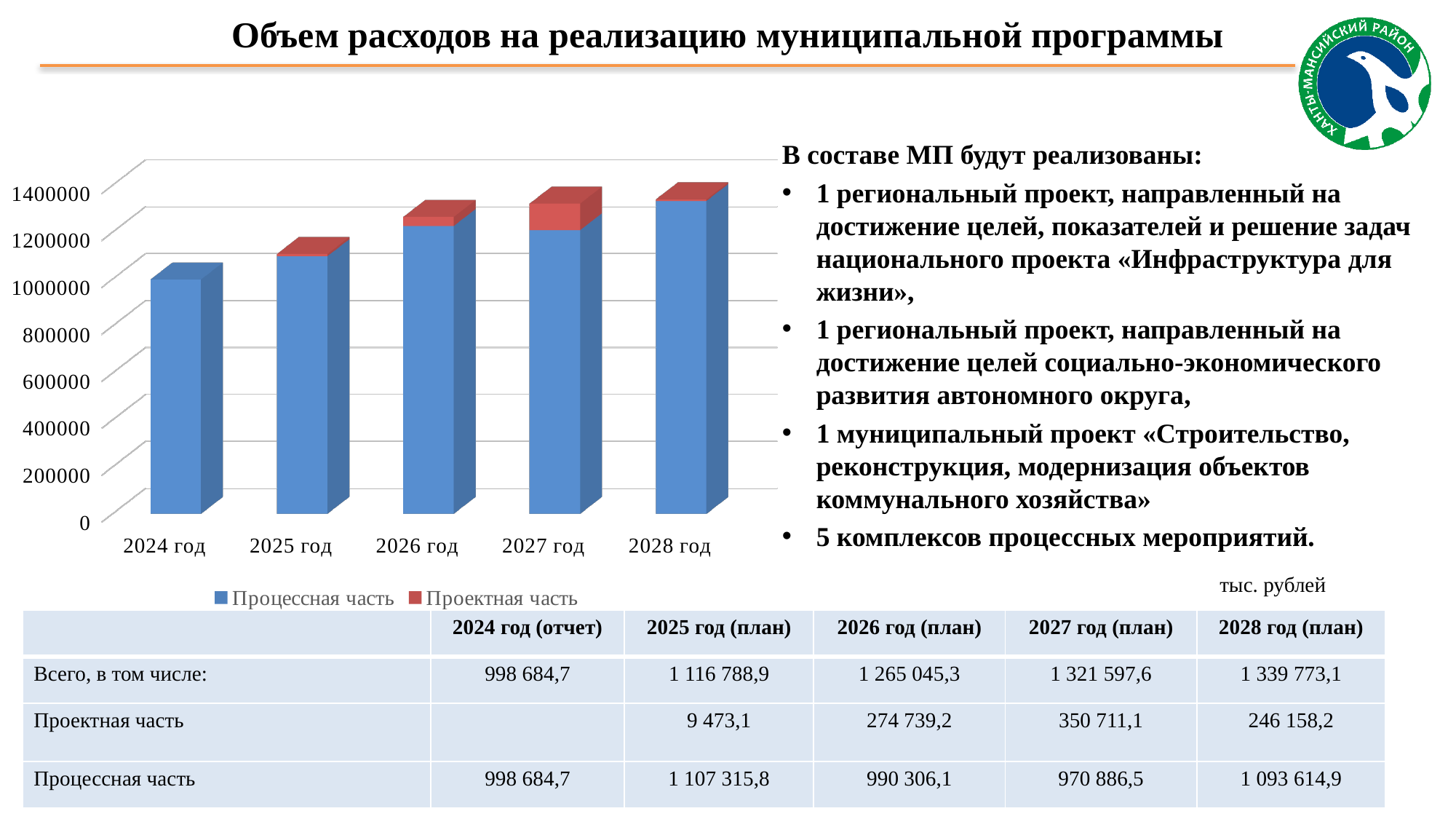
Is the total value for 2028 год greater or less than 1200000? greater What kind of chart is shown on the slide? bar chart Which year has the lowest total bar in the chart? 2024 год What are the two series named in the chart legend? Процессная часть, Проектная часть Do the total bar heights rise or fall from 2024 год to 2028 год? rise Is the total value for 2024 год greater or less than 1200000? less According to the table under the chart, what is the total ('Всего') for 2026 год (план)? 1 265 045,3 How many years (categories) are shown on the x axis of the chart? 5 How many series does the chart legend list? 2 According to the table under the chart, what is the 'Проектная часть' value for 2027 год (план)? 350 711,1 Is the 'Процессная часть' value for 2024 год greater or less than 800000? greater Which colour represents 'Проектная часть' in the chart? red